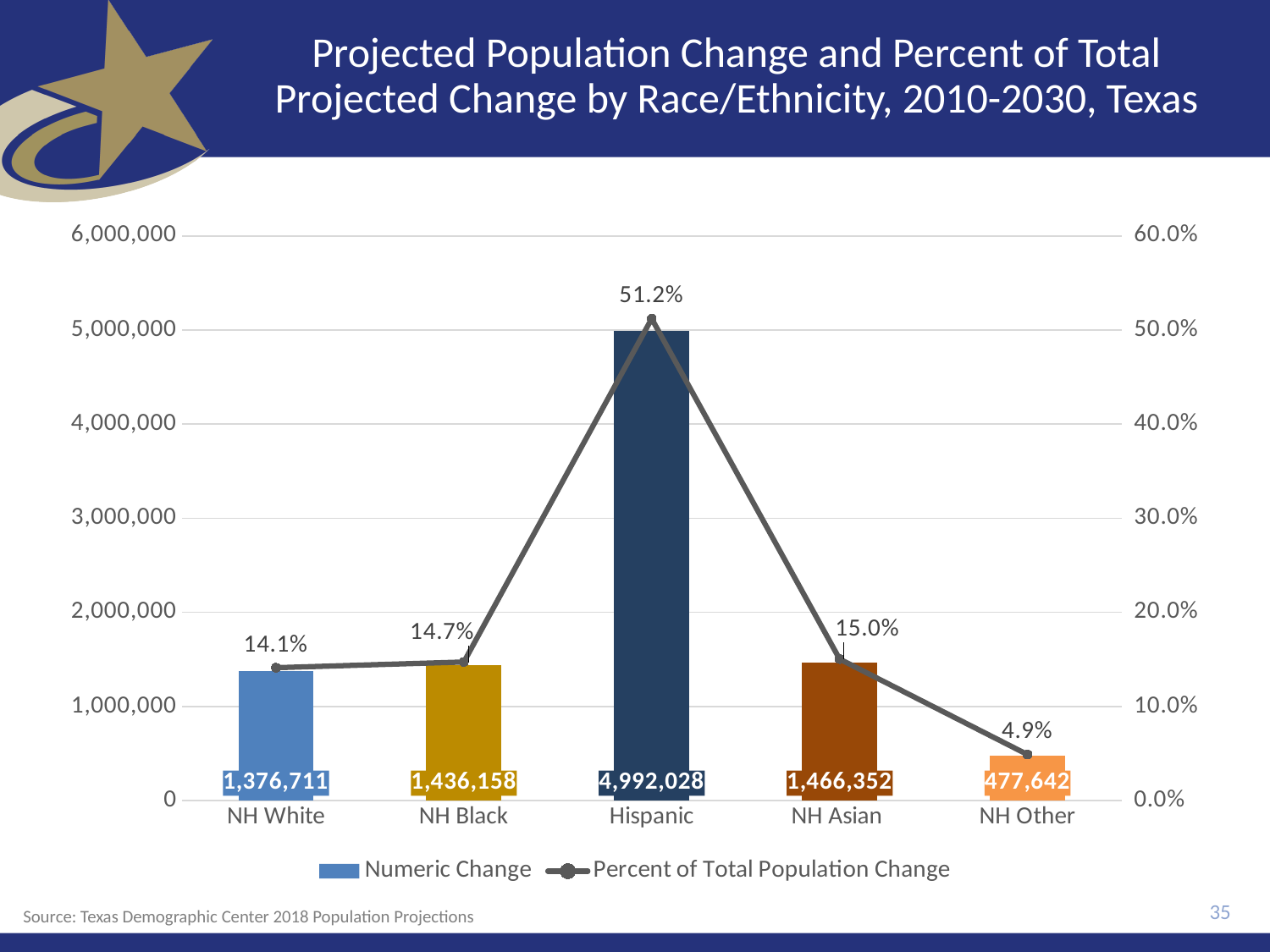
What is the Numeric Change for Hispanic? 4,992,028 Is the Numeric Change for NH Asian greater or less than 1,000,000? greater Which race/ethnicity category has the lowest Percent of Total Population Change? NH Other Which has a larger Numeric Change, NH Black or NH White? NH Black What is the difference in Percent of Total Population Change between NH Black and NH White? 0.6% How many race/ethnicity categories are shown on the x axis? 5 What is the Percent of Total Population Change for NH Asian? 15.0% What is the Numeric Change for NH Other? 477,642 What is the difference in Numeric Change between NH Asian and NH White? 89,641 Which race/ethnicity category has the highest Numeric Change? Hispanic How many series does the legend list? 2 What kind of chart is used to show Numeric Change? bar chart